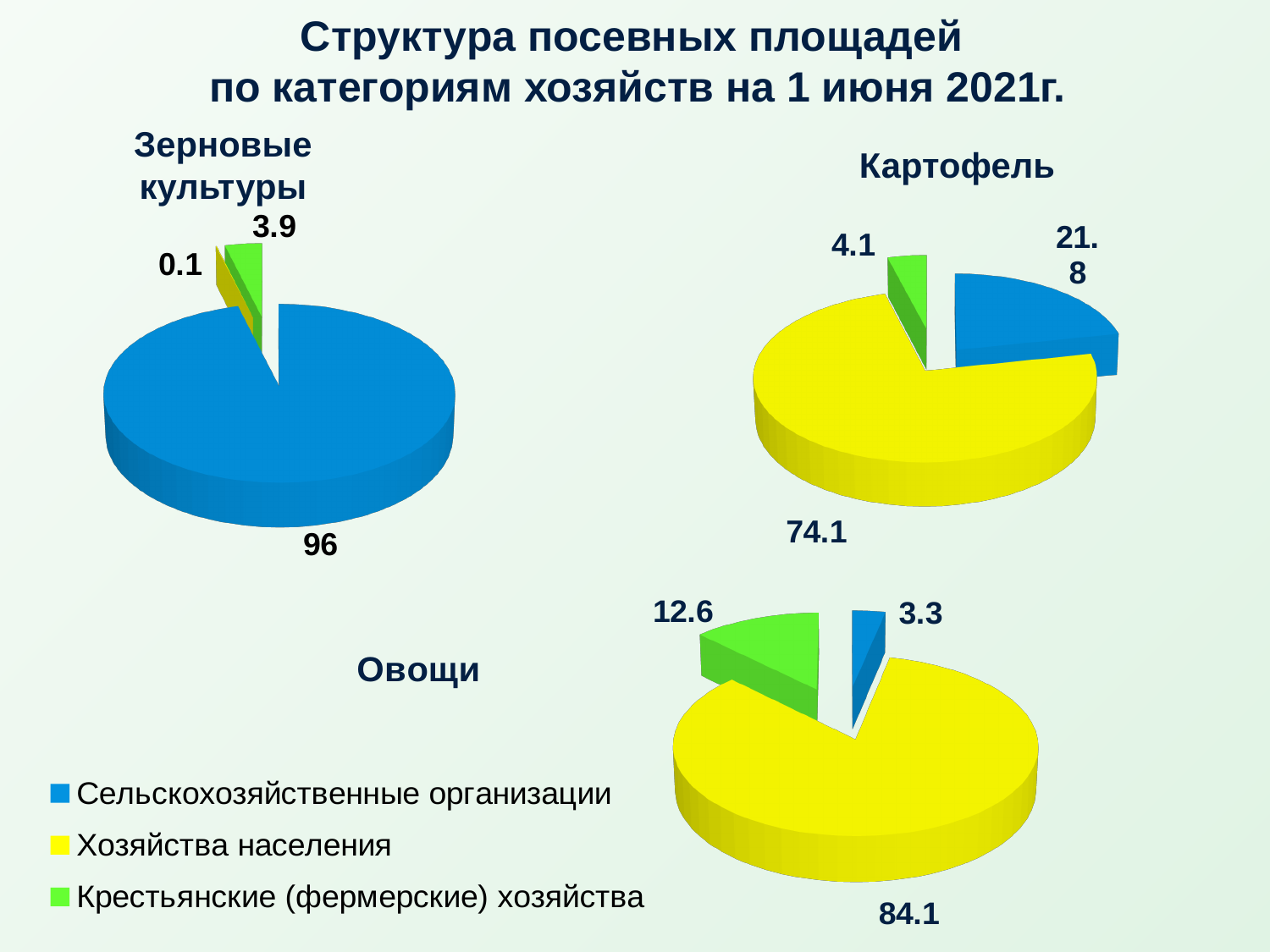
In the 'Овощи' pie chart, which is larger: the value for Крестьянские (фермерские) хозяйства or the value for Сельскохозяйственные организации? Крестьянские (фермерские) хозяйства Which colour represents Хозяйства населения in the legend? Yellow In the 'Картофель' pie chart, what is the value for Хозяйства населения? 74.1 In the 'Картофель' pie chart, what is the value for Сельскохозяйственные организации? 21.8 How many slices does the 'Картофель' pie chart have? 3 How many series does the legend list? 3 In the 'Овощи' pie chart, which category has the largest share? Хозяйства населения In the 'Овощи' pie chart, what is the value for Крестьянские (фермерские) хозяйства? 12.6 In the 'Зерновые культуры' pie chart, what is the value for Сельскохозяйственные организации? 96 In the 'Картофель' pie chart, what is the difference between the values for Хозяйства населения and Сельскохозяйственные организации? 52.3 What kind of chart is the 'Овощи' chart? Pie chart In the 'Зерновые культуры' pie chart, which category has the smallest share? Хозяйства населения